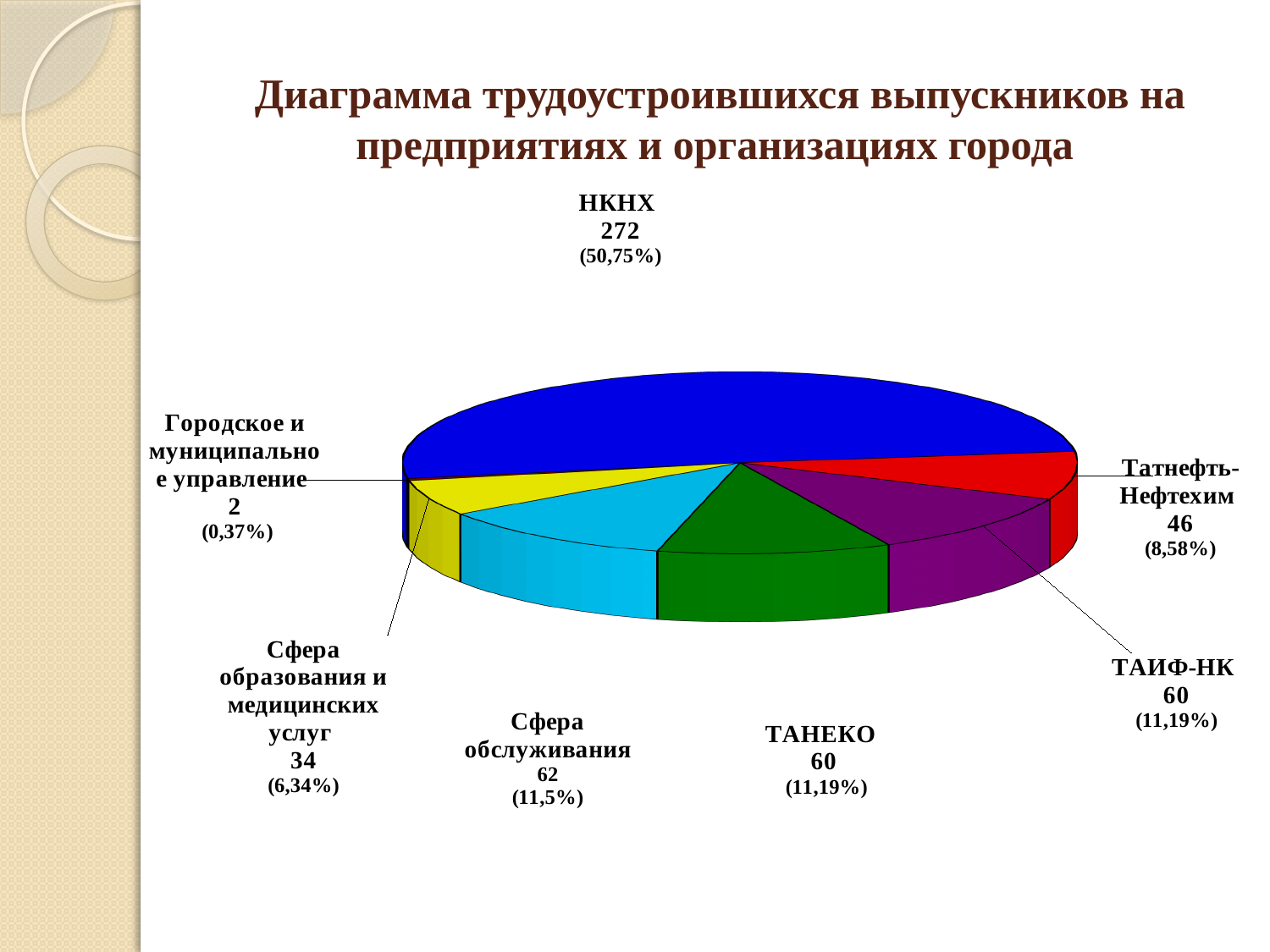
What colour is the НКНХ slice of the pie? blue How many slices does the pie chart have? 7 Which category has the largest slice of the pie? НКНХ Which is larger, the value for Татнефть-Нефтехим or the value for Сфера образования и медицинских услуг? Татнефть-Нефтехим What is the difference between the values for НКНХ and Сфера обслуживания? 210 What value is shown for Сфера обслуживания? 62 What share of the pie does НКНХ represent? 50,75% What value is shown for Татнефть-Нефтехим? 46 How many graduates were employed at НКНХ according to the chart? 272 What percentage is shown for ТАИФ-НК? 11,19% What type of chart is shown on the slide? pie chart Which category has the smallest slice of the pie? Городское и муниципальное управление